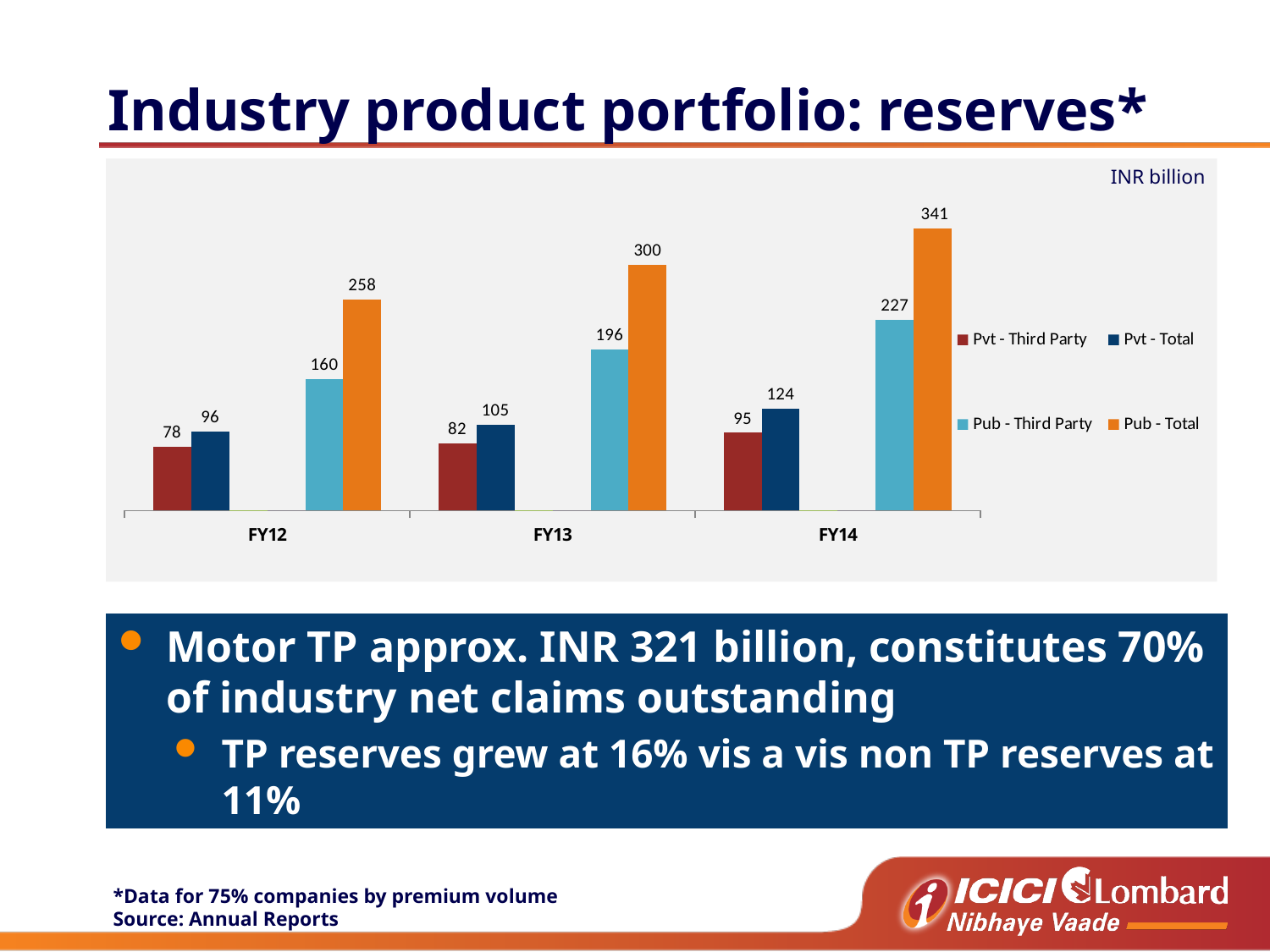
How many series does the legend list? 4 How many fiscal years are shown on the x axis? 3 What kind of chart is shown on the slide? Bar chart What is the difference between Pub - Total and Pub - Third Party in FY13? 104 What is the value for Pub - Total in FY14? 341 In which fiscal year is Pub - Total highest? FY14 Which is larger in FY12: Pvt - Total or Pub - Third Party? Pub - Third Party What is the value for Pub - Third Party in FY13? 196 Does Pub - Third Party rise or fall from FY12 to FY14? Rise What is the value for Pvt - Third Party in FY12? 78 In which fiscal year is Pvt - Third Party lowest? FY12 What is the value for Pvt - Total in FY14? 124